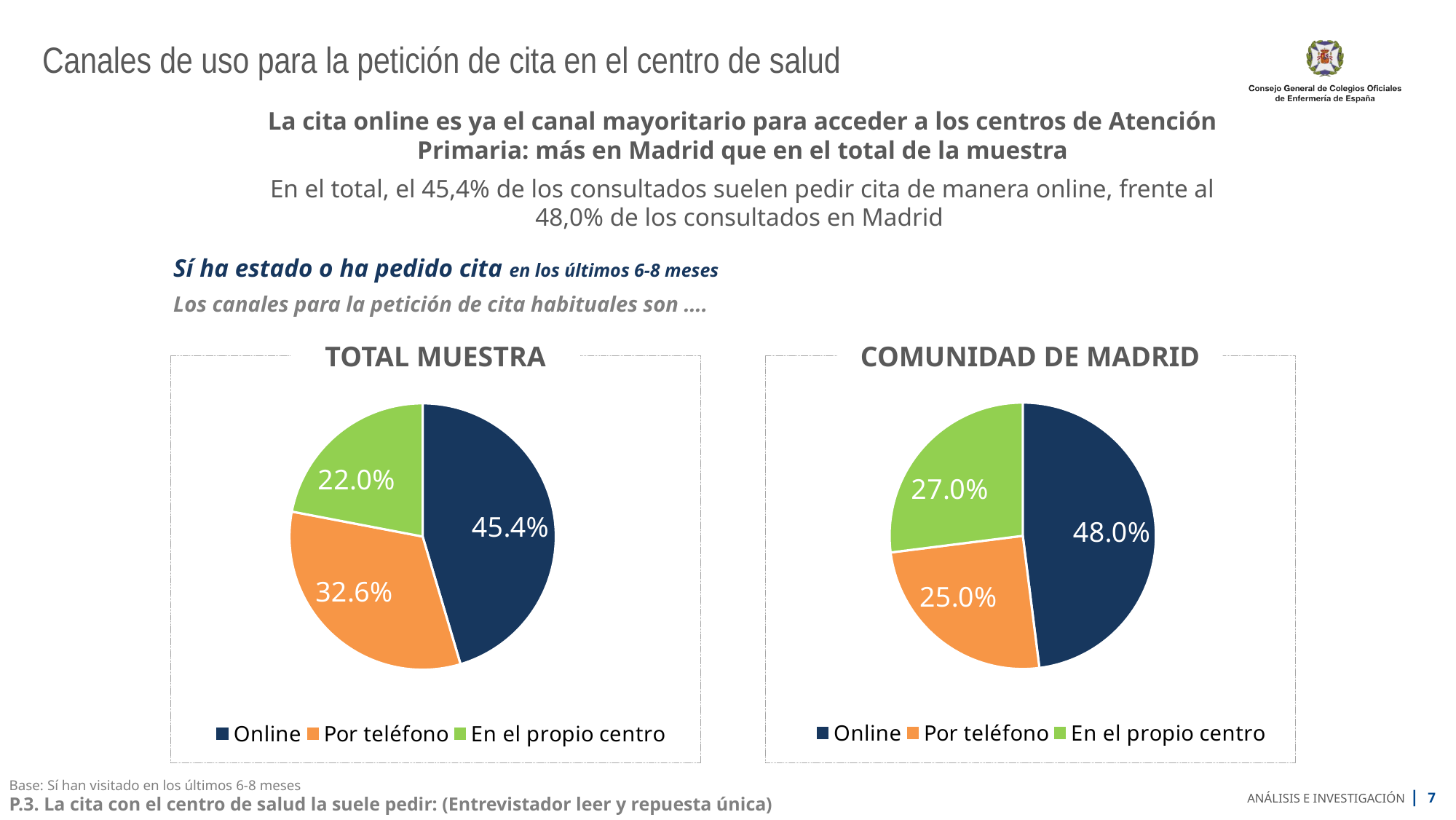
In the COMUNIDAD DE MADRID chart, which category has the largest slice? Online In the TOTAL MUESTRA chart, which category has the smallest slice? En el propio centro In the TOTAL MUESTRA chart, which colour represents Por teléfono? Orange In the COMUNIDAD DE MADRID chart, what is the difference between the Online and En el propio centro percentages? 21.0% In the TOTAL MUESTRA chart, what percentage is shown for En el propio centro? 22.0% In the COMUNIDAD DE MADRID chart, which category has the smallest slice? Por teléfono How many slices does the TOTAL MUESTRA pie chart have? 3 What type of chart is used for COMUNIDAD DE MADRID? Pie chart In the TOTAL MUESTRA chart, what is the difference between the Online and Por teléfono percentages? 12.8% In the COMUNIDAD DE MADRID chart, what percentage is shown for Por teléfono? 25.0% In the TOTAL MUESTRA chart, what percentage is shown for Online? 45.4% Is the Online share larger in the TOTAL MUESTRA chart or in the COMUNIDAD DE MADRID chart? COMUNIDAD DE MADRID